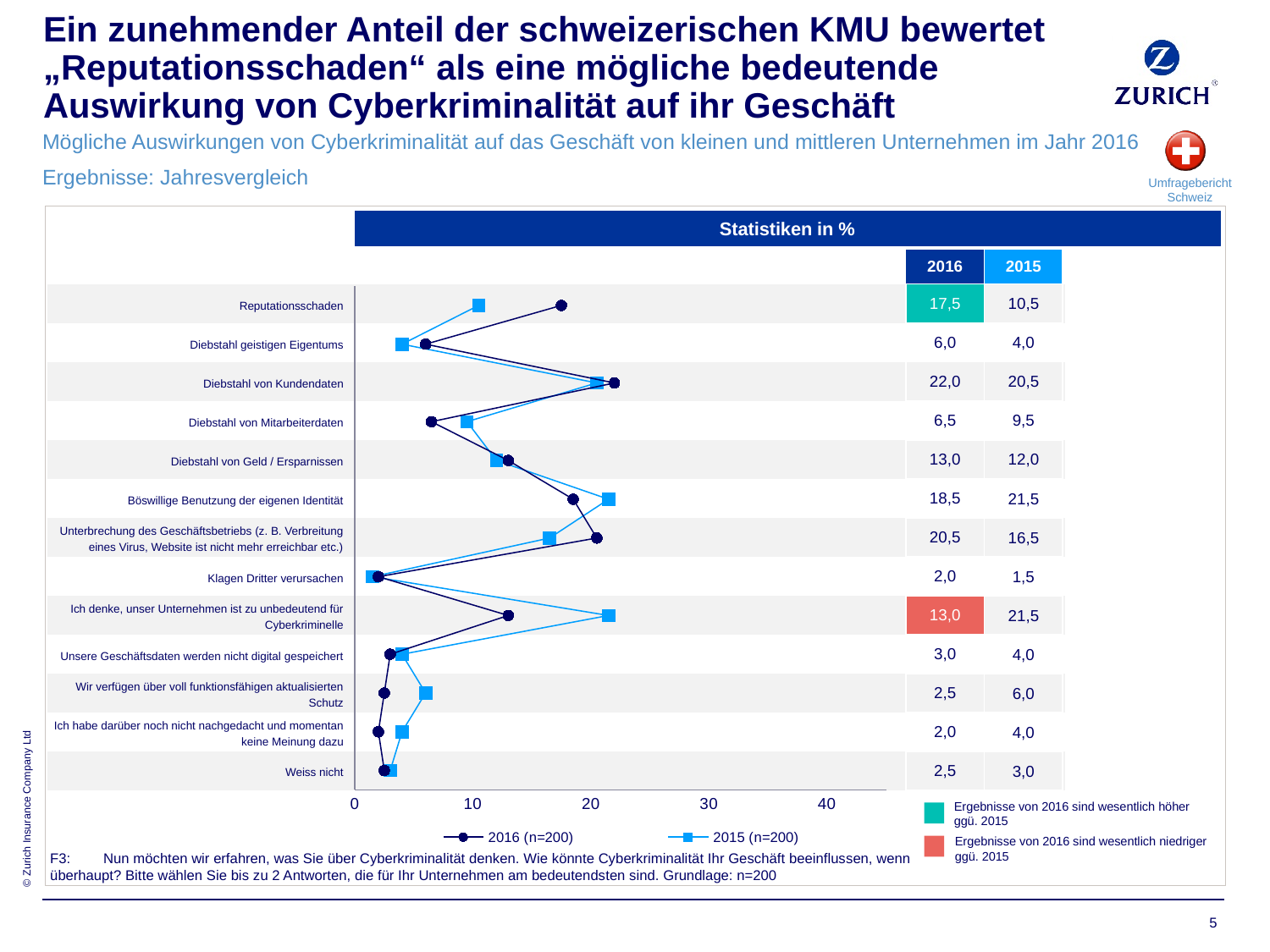
What is the 2015 value for Ich denke, unser Unternehmen ist zu unbedeutend für Cyberkriminelle? 21,5 What is the difference between the 2015 and 2016 values for Wir verfügen über voll funktionsfähigen aktualisierten Schutz? 3,5 Is the 2016 value for Diebstahl von Kundendaten greater or less than 20? greater What is the difference between the 2016 and 2015 values for Reputationsschaden? 7,0 What is the 2016 value for Unterbrechung des Geschäftsbetriebs? 20,5 Which category has the highest 2016 value? Diebstahl von Kundendaten What is the 2016 value for Reputationsschaden? 17,5 Which category has the lowest 2015 value? Klagen Dritter verursachen How many categories are shown on the chart? 13 How many series does the legend list? 2 What kind of chart is shown on the slide? line chart Which is larger for Böswillige Benutzung der eigenen Identität: the 2016 value or the 2015 value? 2015